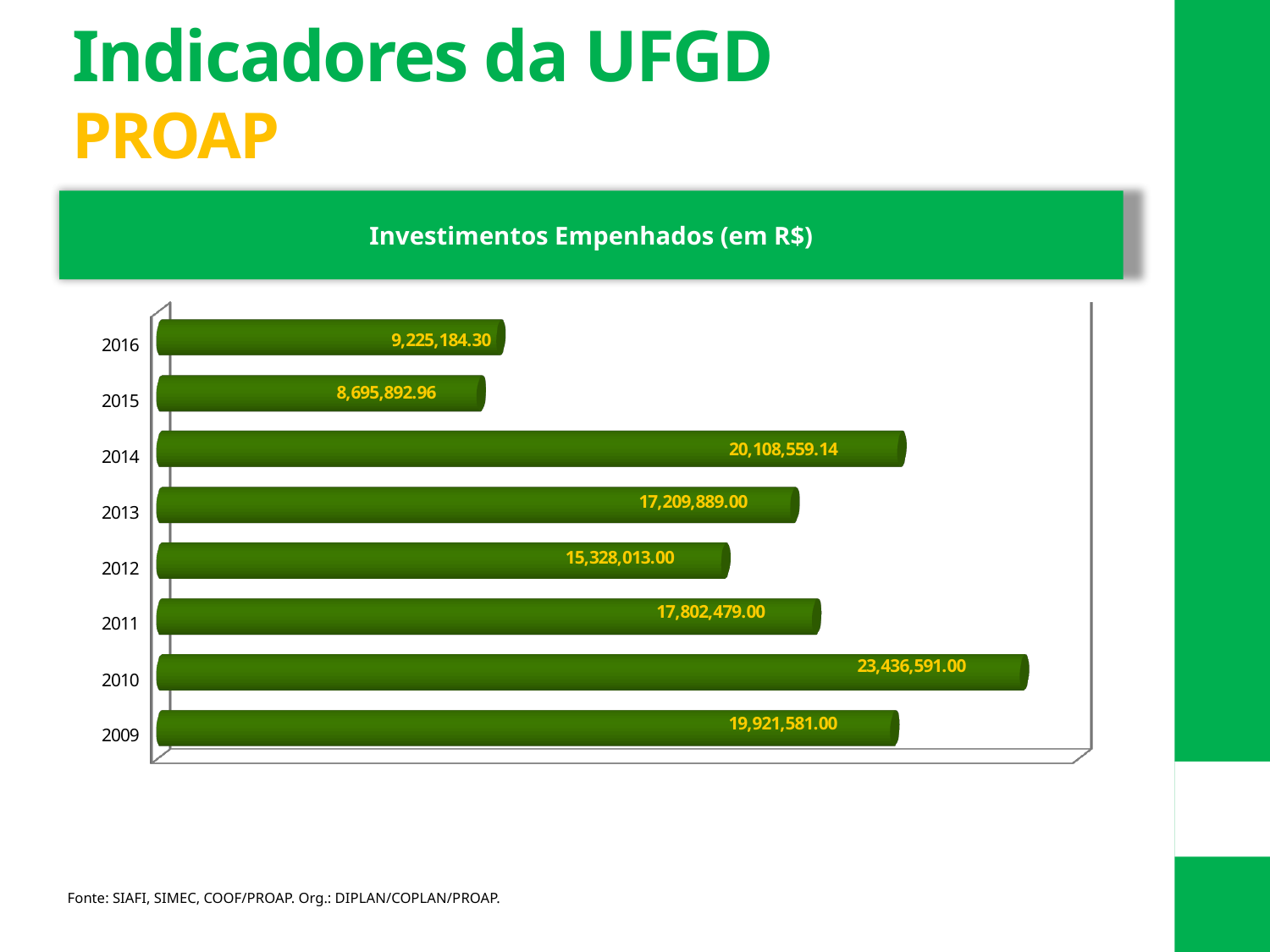
What is the value for 2014 in the Investimentos Empenhados (em R$) chart? 20,108,559.14 What is the value for 2012 in the Investimentos Empenhados (em R$) chart? 15,328,013.00 Which year has the highest value in the Investimentos Empenhados (em R$) chart? 2010 Which year has the larger value in the Investimentos Empenhados (em R$) chart, 2011 or 2012? 2011 What is the value for 2015 in the Investimentos Empenhados (em R$) chart? 8,695,892.96 Which year has the lowest value in the Investimentos Empenhados (em R$) chart? 2015 What kind of chart is the Investimentos Empenhados (em R$) chart? Bar chart What is the difference between the values for 2011 and 2013 in the Investimentos Empenhados (em R$) chart? 592,590.00 What is the value for 2009 in the Investimentos Empenhados (em R$) chart? 19,921,581.00 What is the title of the chart on the slide? Investimentos Empenhados (em R$) How many years are shown in the Investimentos Empenhados (em R$) chart? 8 What is the difference between the values for 2010 and 2015 in the Investimentos Empenhados (em R$) chart? 14,740,698.04